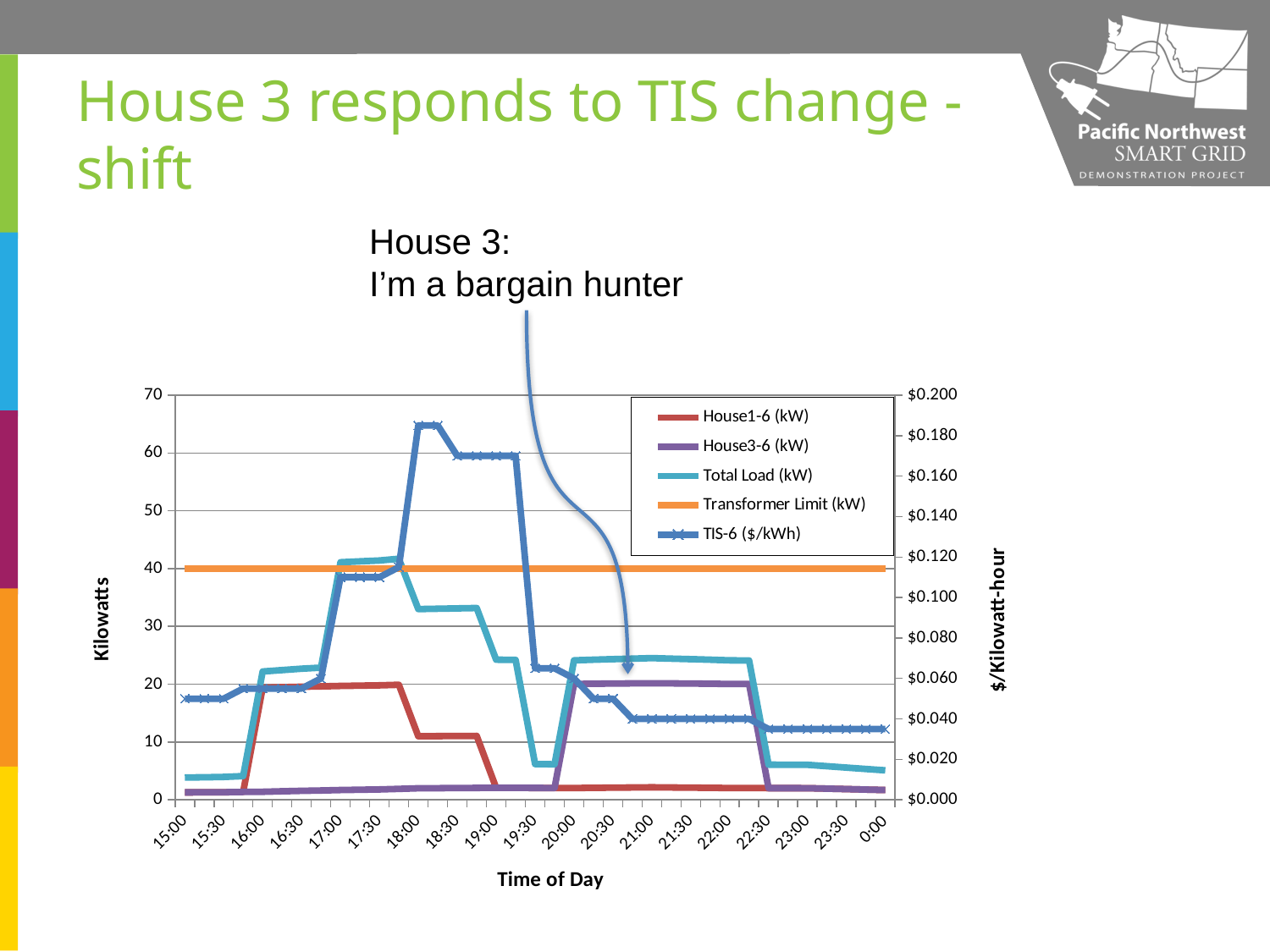
What is the value of the Transformer Limit (kW) series? 40 Is the Total Load (kW) value at 19:30 greater or less than 10? less What kind of chart is shown on the slide? line chart What is the title of the x axis? Time of Day Is the TIS-6 ($/kWh) value at 23:00 greater or less than $0.060? less Which is larger: the Total Load (kW) at 18:00 or the Total Load (kW) at 21:00? Total Load at 18:00 Is the TIS-6 ($/kWh) value at 18:00 greater or less than $0.160? greater Does the Total Load (kW) series rise or fall between 18:00 and 19:30? fall What is the title of the right-hand y axis? $/Kilowatt-hour How many series does the chart legend list? 5